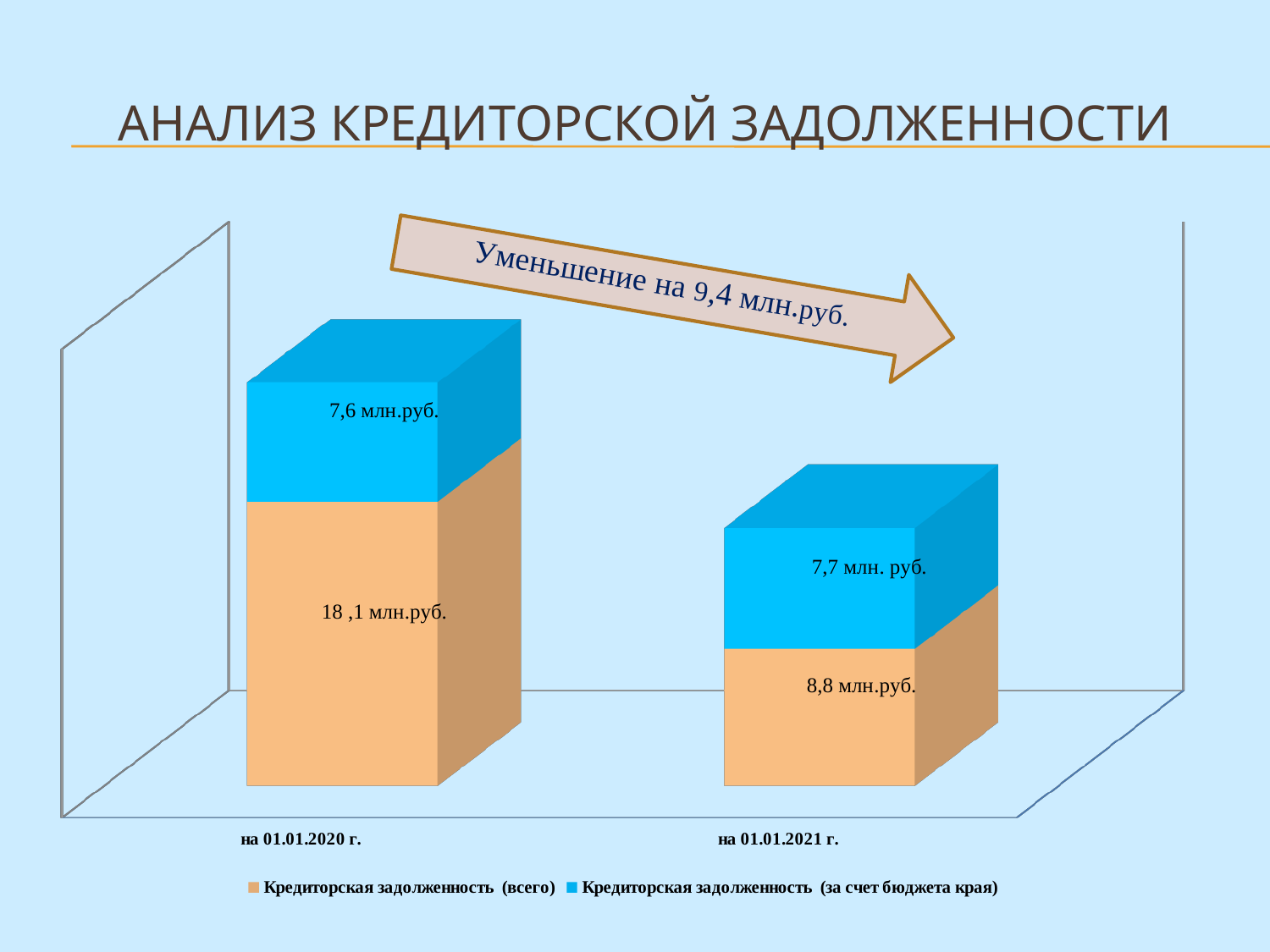
What type of chart is shown on the slide? stacked bar chart What is the value of Кредиторская задолженность (всего) на 01.01.2020 г.? 18,1 млн.руб. What is the value of Кредиторская задолженность (за счет бюджета края) на 01.01.2020 г.? 7,6 млн.руб. What is the value of Кредиторская задолженность (всего) на 01.01.2021 г.? 8,8 млн.руб. Does Кредиторская задолженность (всего) rise or fall from 01.01.2020 to 01.01.2021? fall By how much did Кредиторская задолженность (всего) change from 01.01.2020 to 01.01.2021 according to the data labels? 9,3 млн.руб. What decrease does the arrow on the chart state? Уменьшение на 9,4 млн.руб. What is the value of Кредиторская задолженность (за счет бюджета края) на 01.01.2021 г.? 7,7 млн. руб. Which date has the higher value for Кредиторская задолженность (всего)? на 01.01.2020 г. How many series does the legend list? 2 Which date has the lower value for Кредиторская задолженность (всего)? на 01.01.2021 г. How many categories (dates) are shown on the x axis? 2